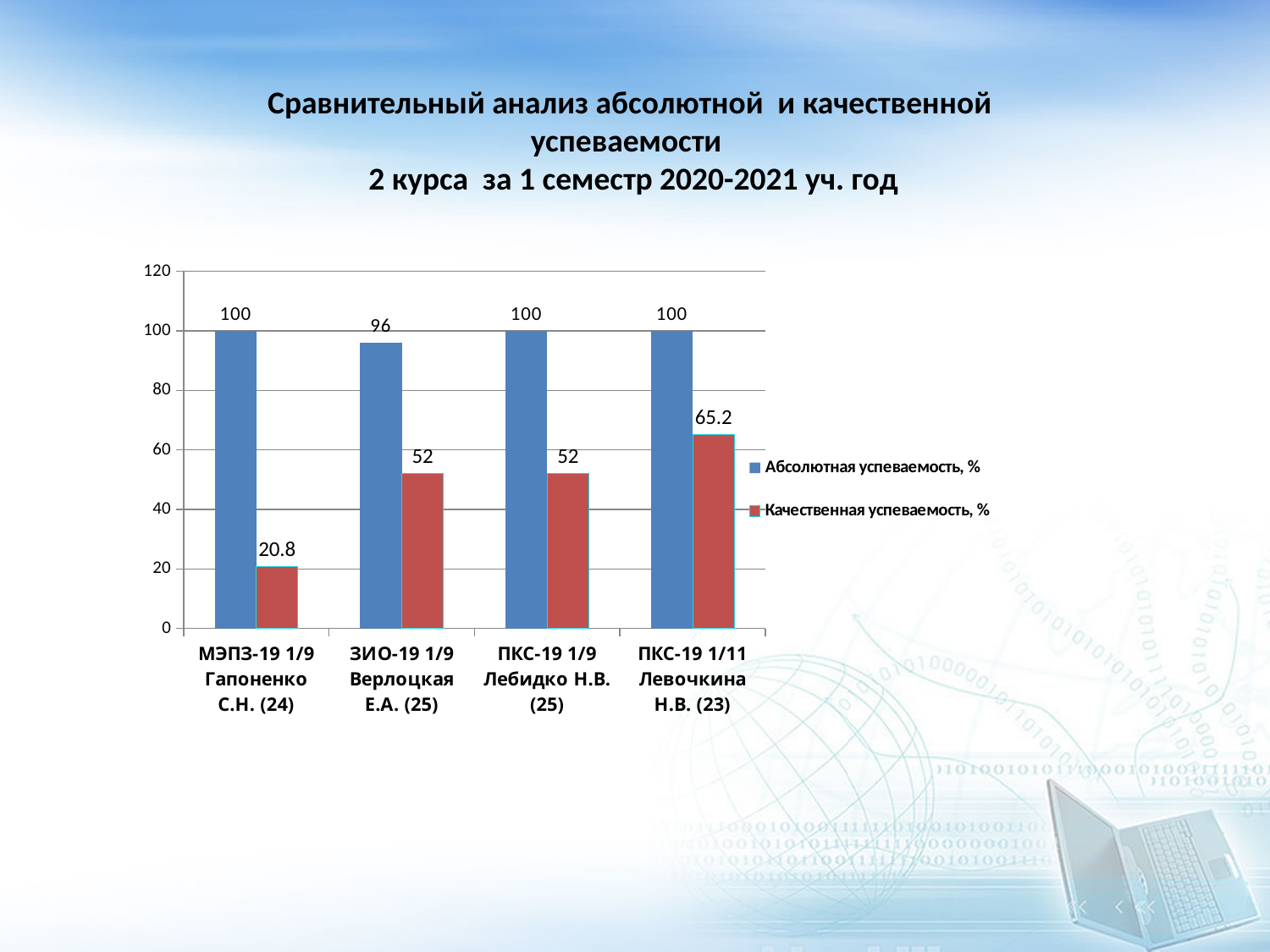
Which group has the lowest Абсолютная успеваемость, %? ЗИО-19 1/9 Верлоцкая Е.А. (25) What is the value of Абсолютная успеваемость, % for ЗИО-19 1/9 Верлоцкая Е.А. (25)? 96 Which group has the highest Качественная успеваемость, %? ПКС-19 1/11 Левочкина Н.В. (23) What is the difference in Качественная успеваемость, % between ПКС-19 1/11 Левочкина Н.В. (23) and МЭПЗ-19 1/9 Гапоненко С.Н. (24)? 44.4 What is the difference between Абсолютная успеваемость, % and Качественная успеваемость, % for ПКС-19 1/9 Лебидко Н.В. (25)? 48 Which is larger: Качественная успеваемость, % for ЗИО-19 1/9 Верлоцкая Е.А. (25) or for МЭПЗ-19 1/9 Гапоненко С.Н. (24)? ЗИО-19 1/9 Верлоцкая Е.А. (25) What is the value of Качественная успеваемость, % for ПКС-19 1/11 Левочкина Н.В. (23)? 65.2 How many groups are shown on the x axis of the chart? 4 What kind of chart is shown on the slide? Bar chart Which group has the lowest Качественная успеваемость, %? МЭПЗ-19 1/9 Гапоненко С.Н. (24) How many series does the legend list? 2 What is the value of Качественная успеваемость, % for МЭПЗ-19 1/9 Гапоненко С.Н. (24)? 20.8